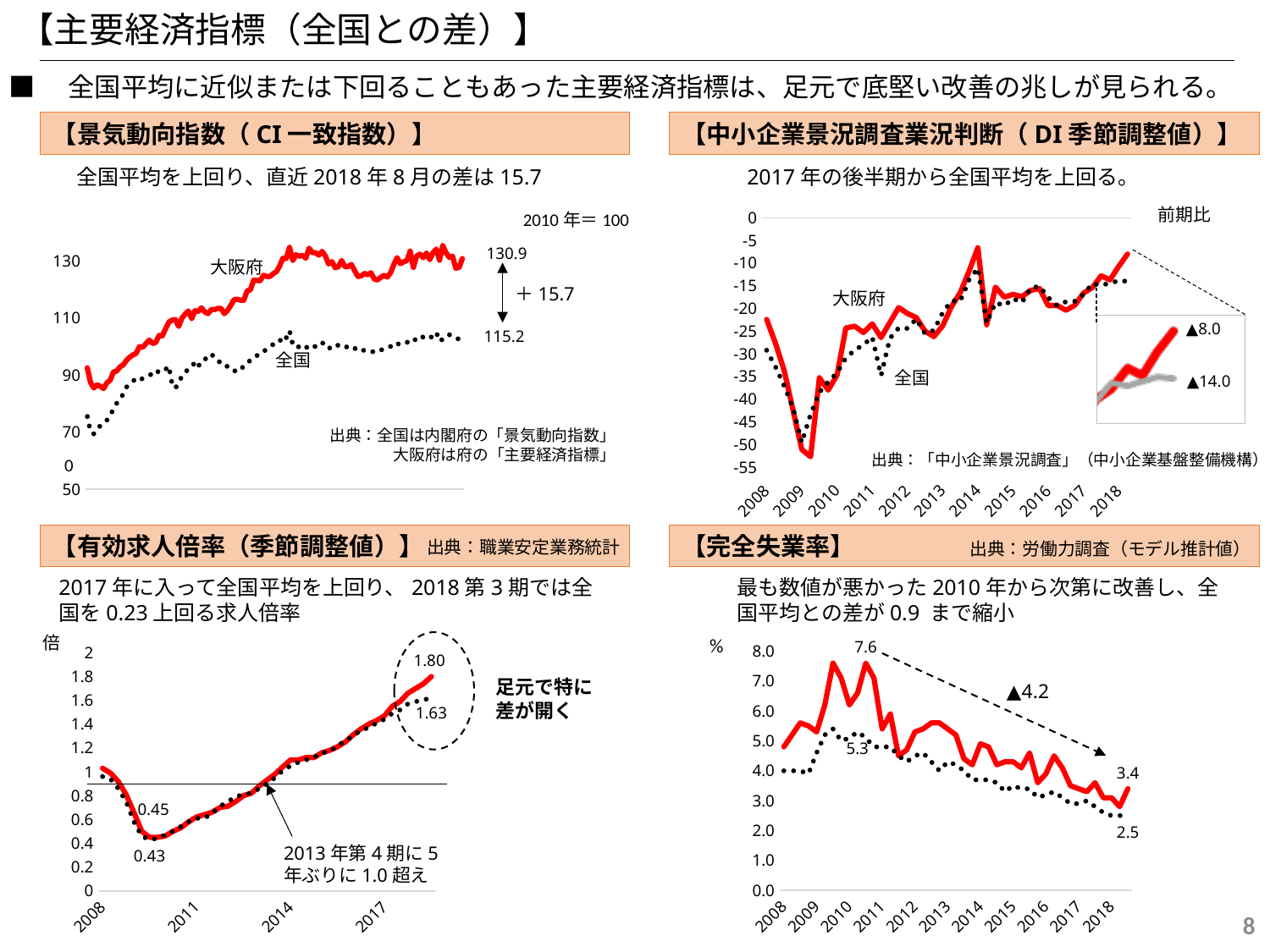
In the 【中小企業景況調査業況判断（DI季節調整値）】 chart, is the lowest value for 大阪府 around 2009 greater or less than -40? less In the 【完全失業率】 chart, what is the peak value labeled for 大阪府? 7.6 In the 【有効求人倍率（季節調整値）】 chart, what is the latest value labeled for the 全国 (dotted) line? 1.63 How many series are plotted in the 【完全失業率】 chart? 2 In the 【景気動向指数（CI一致指数）】 chart, what is the latest value labeled for 全国? 115.2 In the 【完全失業率】 chart, what is the difference between the latest 大阪府 value (3.4) and the latest 全国 value (2.5)? 0.9 In the 【中小企業景況調査業況判断（DI季節調整値）】 chart, which series has the higher latest value, 大阪府 (▲8.0) or 全国 (▲14.0)? 大阪府 In the 【景気動向指数（CI一致指数）】 chart, what is the latest value labeled for 大阪府? 130.9 What kind of chart is the 【景気動向指数（CI一致指数）】 chart? line chart In the 【景気動向指数（CI一致指数）】 chart, what is the difference between the latest 大阪府 value (130.9) and the latest 全国 value (115.2)? 15.7 In the 【完全失業率】 chart, does the 大阪府 line rise or fall from 2010 to 2018? fall In the 【有効求人倍率（季節調整値）】 chart, what is the latest value labeled for the 大阪府 (red) line? 1.80